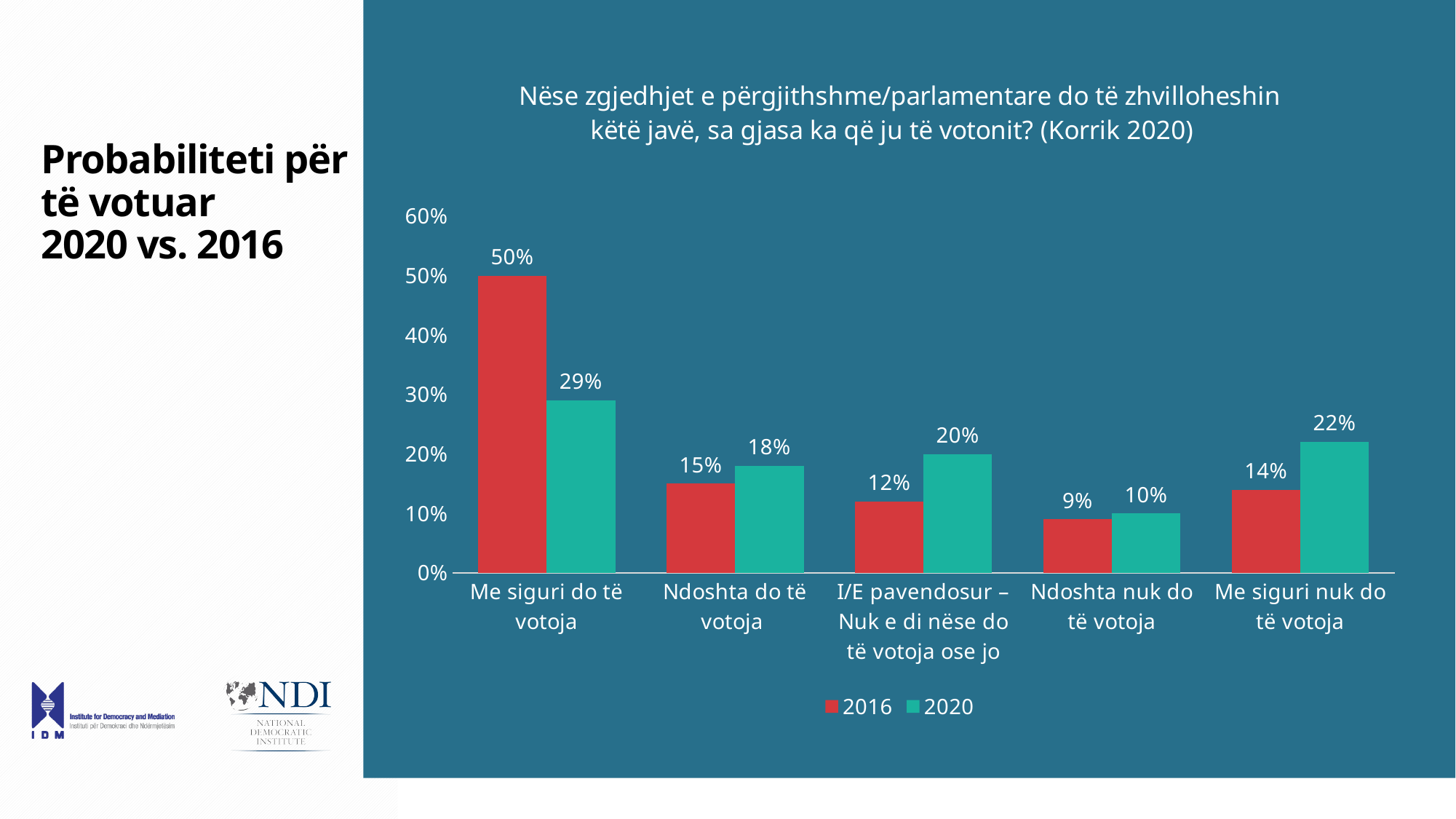
What is the 2020 value for "Me siguri nuk do të votoja"? 22% What is the difference between the 2020 and 2016 values for "Me siguri nuk do të votoja"? 8% What is the 2016 value for "Me siguri do të votoja"? 50% Which is larger for "Ndoshta do të votoja": the 2016 value or the 2020 value? 2020 Which category has the highest 2016 value? Me siguri do të votoja What is the 2020 value for "I/E pavendosur – Nuk e di nëse do të votoja ose jo"? 20% What kind of chart is shown on the slide? Bar chart How many categories are shown on the x axis? 5 What is the difference between the 2016 and 2020 values for "Me siguri do të votoja"? 21% Which category has the lowest 2020 value? Ndoshta nuk do të votoja How many series does the legend list? 2 Which colour represents the 2020 series in the chart? Teal (green)